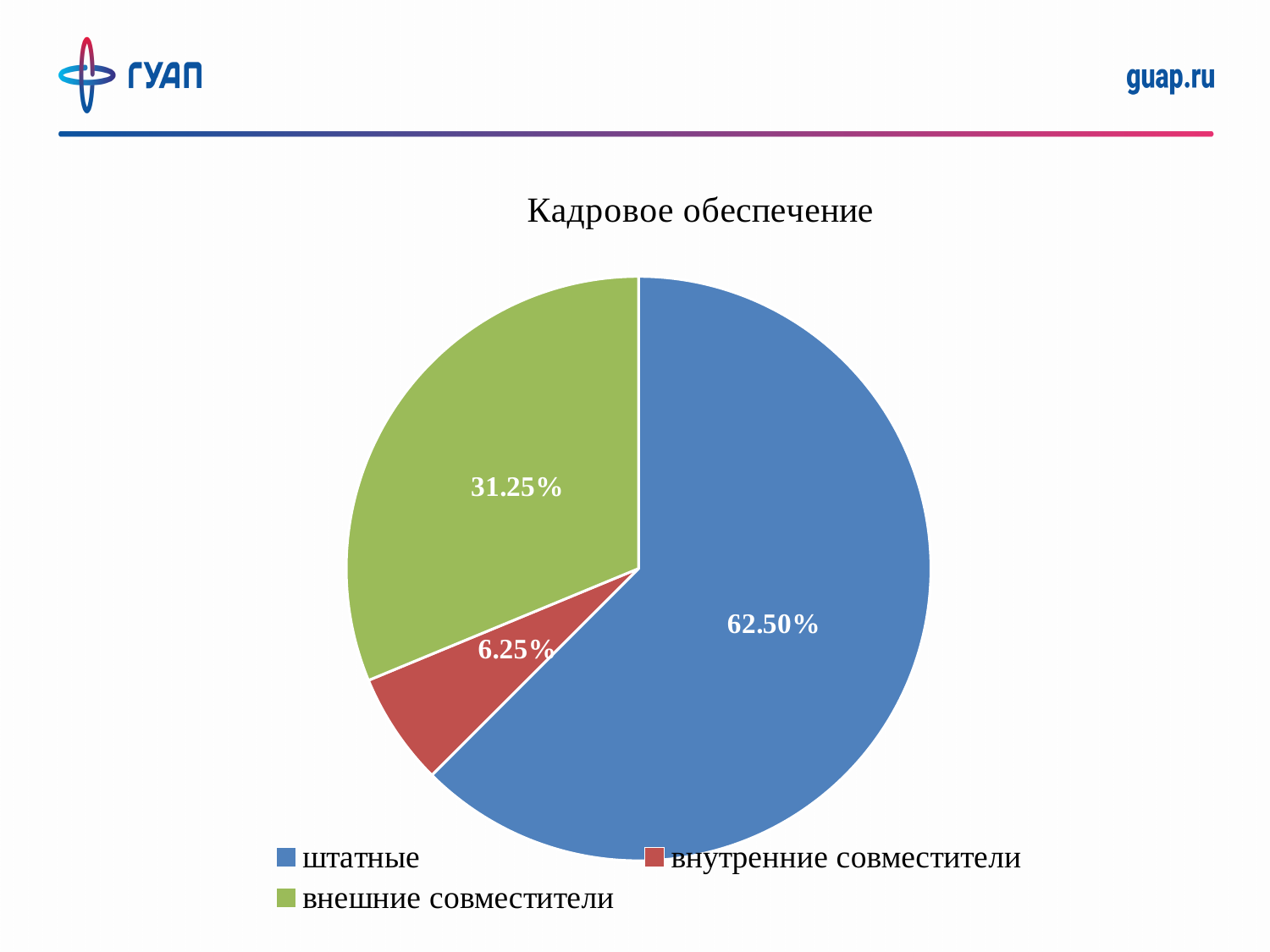
How many slices does the pie chart have? 3 What is the title of the chart? Кадровое обеспечение Which is larger, the share for 'внешние совместители' or for 'внутренние совместители'? внешние совместители What share of the pie does the 'внутренние совместители' slice represent? 6.25% What type of chart is shown on the slide? pie chart What colour is the 'внутренние совместители' slice? red How many entries does the legend list? 3 Which category has the largest share of the pie? штатные What share of the pie does the 'внешние совместители' slice represent? 31.25% Which category has the smallest share of the pie? внутренние совместители What share of the pie does the 'штатные' slice represent? 62.50% What is the difference in percentage points between the 'штатные' and 'внешние совместители' slices? 31.25